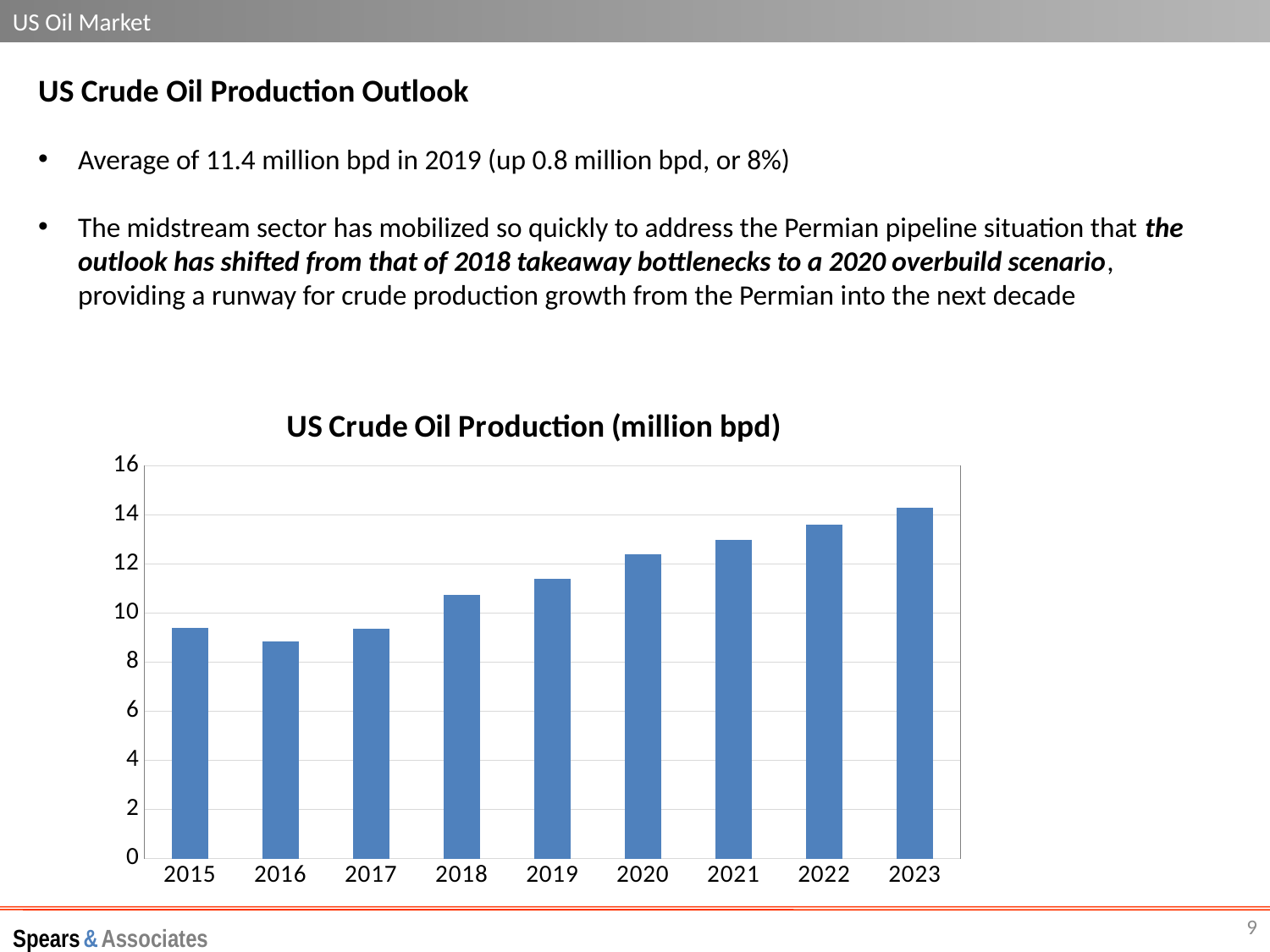
What kind of chart is shown on the slide? bar chart Is the value for 2021 greater or less than 12? greater What is the title of the chart? US Crude Oil Production (million bpd) Which year has the highest US crude oil production in the chart? 2023 Do the values generally rise or fall from 2017 to 2023? rise Is the value for 2023 greater or less than 12? greater How many years are shown on the x axis of the chart? 9 Which is larger, the value for 2018 or the value for 2016? 2018 Is the value for 2019 greater or less than 10? greater Which year has the lowest US crude oil production in the chart? 2016